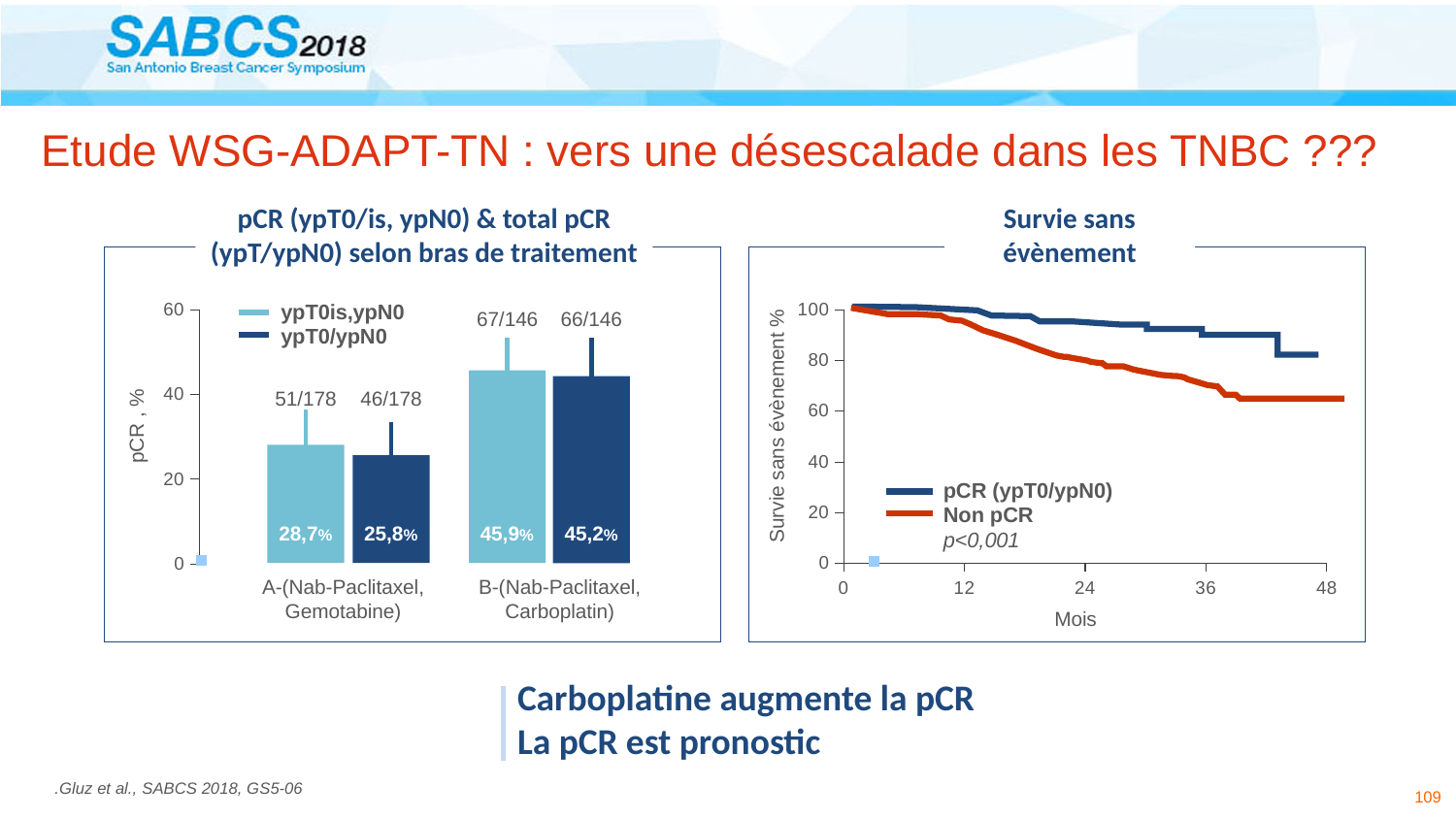
In the left chart (pCR selon bras de traitement), how many treatment arms are shown on the x axis? 2 What kind of chart is the left chart (pCR selon bras de traitement)? Bar chart In the left chart (pCR selon bras de traitement), how many series does the legend list? 2 In the left chart (pCR selon bras de traitement), what is the ypT0is,ypN0 value for arm A-(Nab-Paclitaxel, Gemotabine)? 28,7% In the left chart (pCR selon bras de traitement), what is the difference between the ypT0is,ypN0 rates of arm B and arm A? 17,2% In the right chart (Survie sans évènement), what p-value is printed below the legend? p<0,001 In the left chart (pCR selon bras de traitement), what is the ypT0/ypN0 value for arm B-(Nab-Paclitaxel, Carboplatin)? 45,2% In the left chart (pCR selon bras de traitement), which treatment arm has the highest ypT0is,ypN0 pCR rate? B-(Nab-Paclitaxel, Carboplatin) In the left chart (pCR selon bras de traitement), what fraction is printed above the ypT0is,ypN0 bar for arm B-(Nab-Paclitaxel, Carboplatin)? 67/146 In the right chart (Survie sans évènement), is the Non pCR curve at 36 months greater or less than 80? less In the left chart (pCR selon bras de traitement), which is larger for arm A: the ypT0is,ypN0 rate or the ypT0/ypN0 rate? ypT0is,ypN0 In the right chart (Survie sans évènement), how many series does the legend list? 2